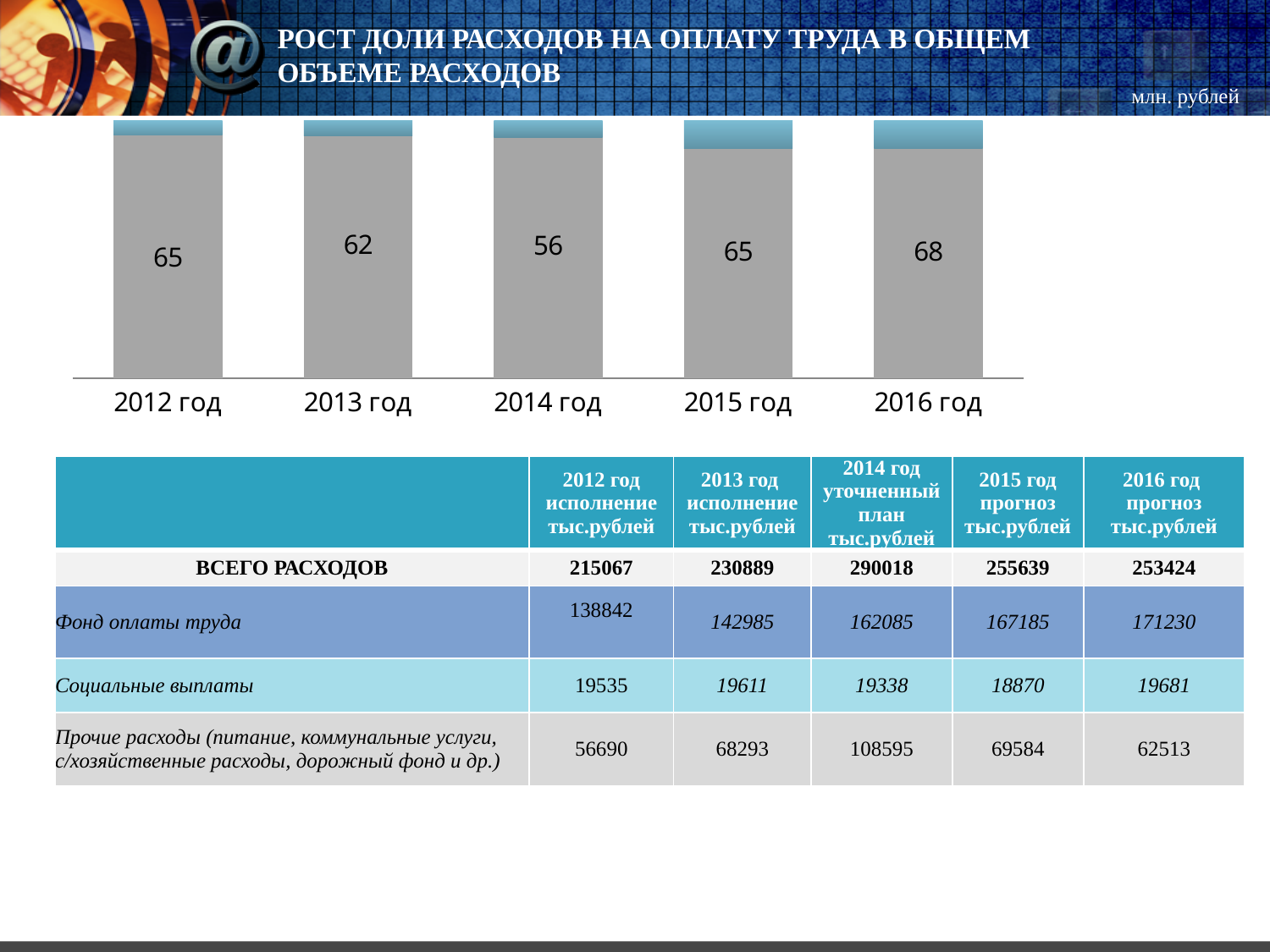
What unit is indicated in the top right corner above the chart? млн. рублей Do the labelled values rise or fall from 2014 год to 2016 год? rise Which is larger, the labelled value for 2013 год or for 2015 год? 2015 год What kind of chart is shown on the slide? bar chart How many years are shown on the x axis of the chart? 5 What is the value shown on the bar for 2013 год? 62 What is the value shown on the bar for 2012 год? 65 What is the value shown on the bar for 2014 год? 56 Which year has the highest labelled value in the chart? 2016 год What is the value shown on the bar for 2016 год? 68 Which year has the lowest labelled value in the chart? 2014 год What is the difference between the labelled values for 2016 год and 2014 год? 12